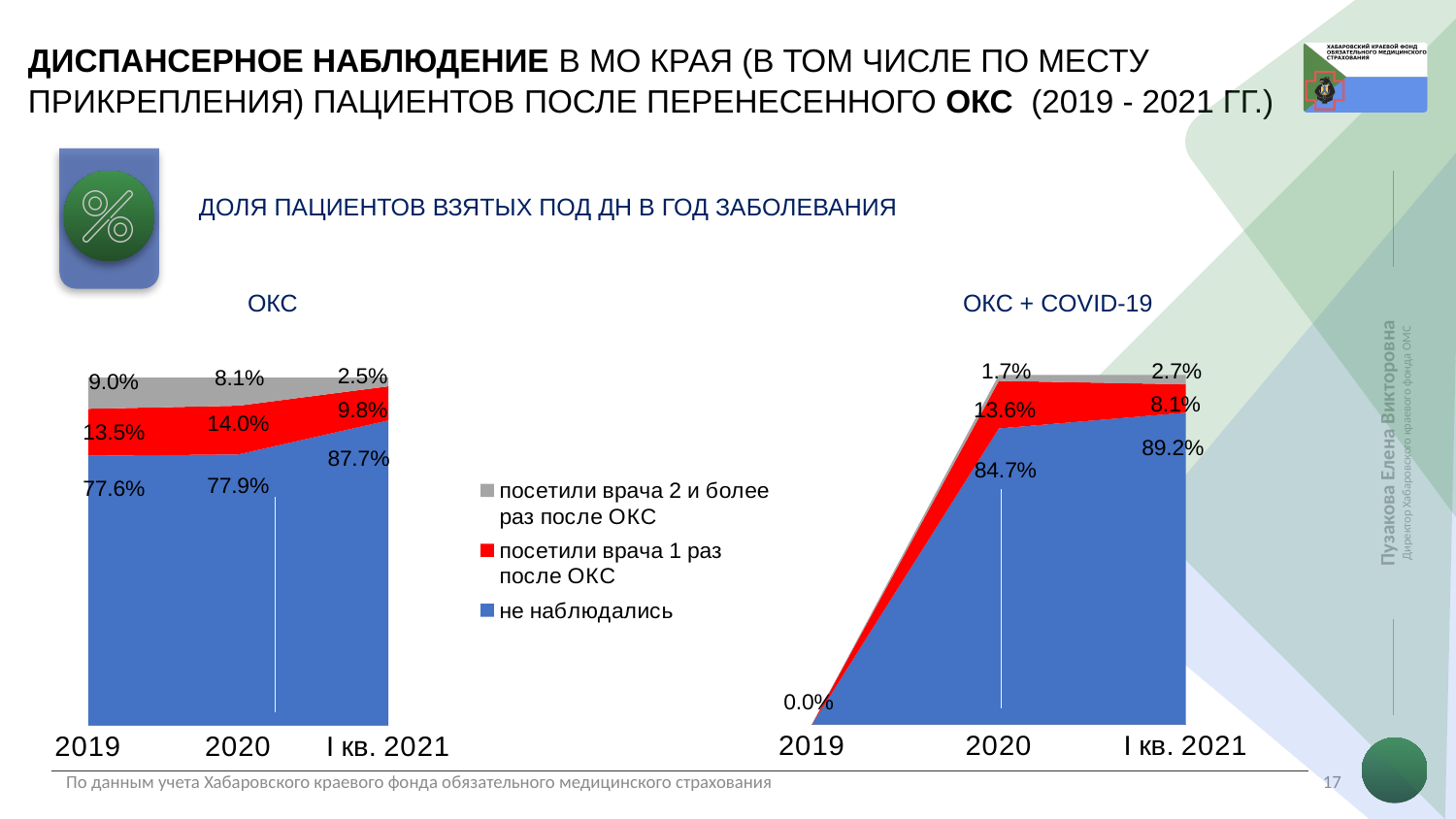
What kind of chart is the ОКС + COVID-19 chart? Stacked area chart In the ОКС chart, what is the difference between the "не наблюдались" values for I кв. 2021 and 2020? 9.8% In the ОКС + COVID-19 chart, which is larger: the "посетили врача 1 раз после ОКС" value in 2020 or in I кв. 2021? 2020 In the ОКС chart, what is the value for "посетили врача 1 раз после ОКС" in 2020? 14.0% How many series does the legend list? 3 In the ОКС + COVID-19 chart, what is the value for "посетили врача 1 раз после ОКС" in I кв. 2021? 8.1% In the ОКС chart, what is the value for "не наблюдались" in 2019? 77.6% How many periods are shown on the x axis of the ОКС chart? 3 In the ОКС chart, in which period is the value for "не наблюдались" highest? I кв. 2021 In the ОКС chart, what is the value for "посетили врача 2 и более раз после ОКС" in I кв. 2021? 2.5% In the ОКС chart, in which period is the value for "посетили врача 2 и более раз после ОКС" lowest? I кв. 2021 In the ОКС + COVID-19 chart, what is the value for "не наблюдались" in 2020? 84.7%